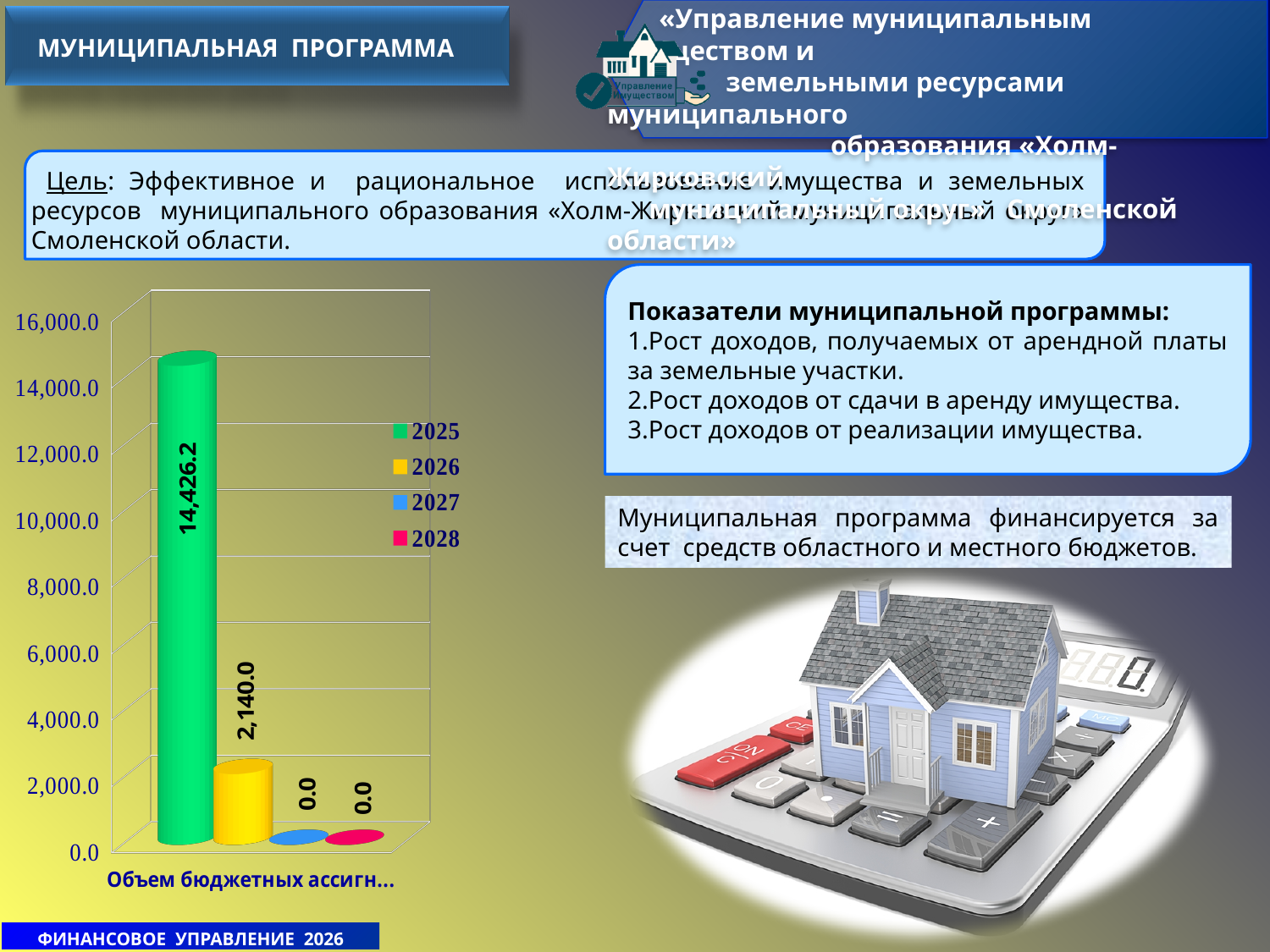
What colour is the bar for 2026 in the chart? yellow Is the value for 2026 greater or less than 4,000.0? less What is the value for 2026 in the chart? 2,140.0 Which is larger, the value for 2025 or the value for 2026? 2025 What kind of chart is shown on the slide? bar chart What is the value for 2028 in the chart? 0.0 What is the difference between the values for 2025 and 2026? 12,286.2 Is the value for 2025 greater or less than 14,000.0? greater How many series does the legend list? 4 What is the value for 2025 in the chart? 14,426.2 What is the value for 2027 in the chart? 0.0 Which year has the highest value in the chart? 2025